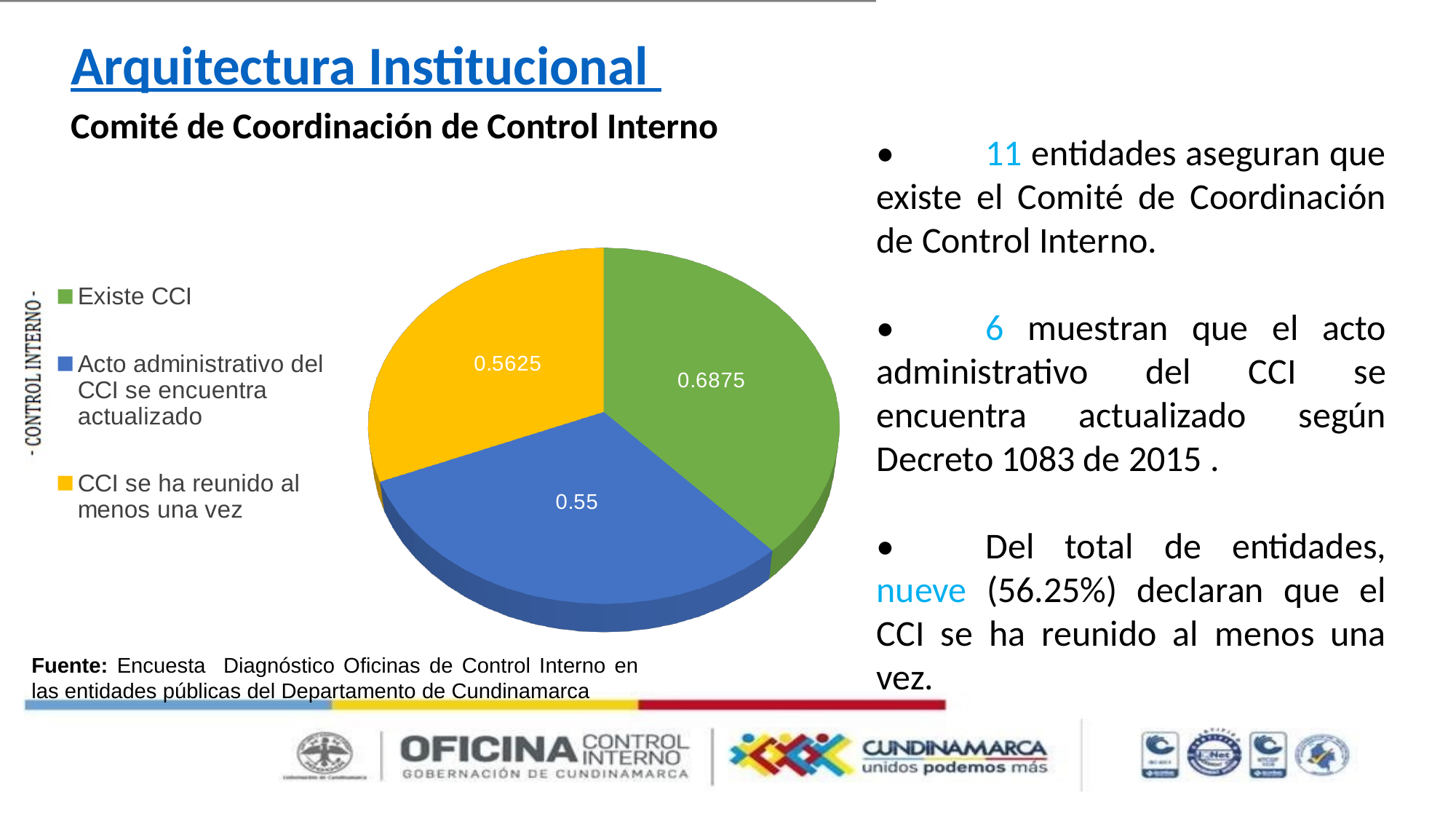
What colour is the 'Existe CCI' slice? Green Which category has the lowest value in the pie chart? Acto administrativo del CCI se encuentra actualizado What kind of chart is shown on the slide? Pie chart How many slices does the pie chart have? 3 Which category has the highest value in the pie chart? Existe CCI How many entries does the legend list? 3 What is the value shown for the 'CCI se ha reunido al menos una vez' slice? 0.5625 What is the difference between the values for 'Existe CCI' and 'CCI se ha reunido al menos una vez'? 0.125 What is the value shown for the 'Acto administrativo del CCI se encuentra actualizado' slice? 0.55 What is the difference between the values for 'Existe CCI' and 'Acto administrativo del CCI se encuentra actualizado'? 0.1375 Which is larger: the value for 'Existe CCI' or the value for 'Acto administrativo del CCI se encuentra actualizado'? Existe CCI What is the value shown for the 'Existe CCI' slice? 0.6875